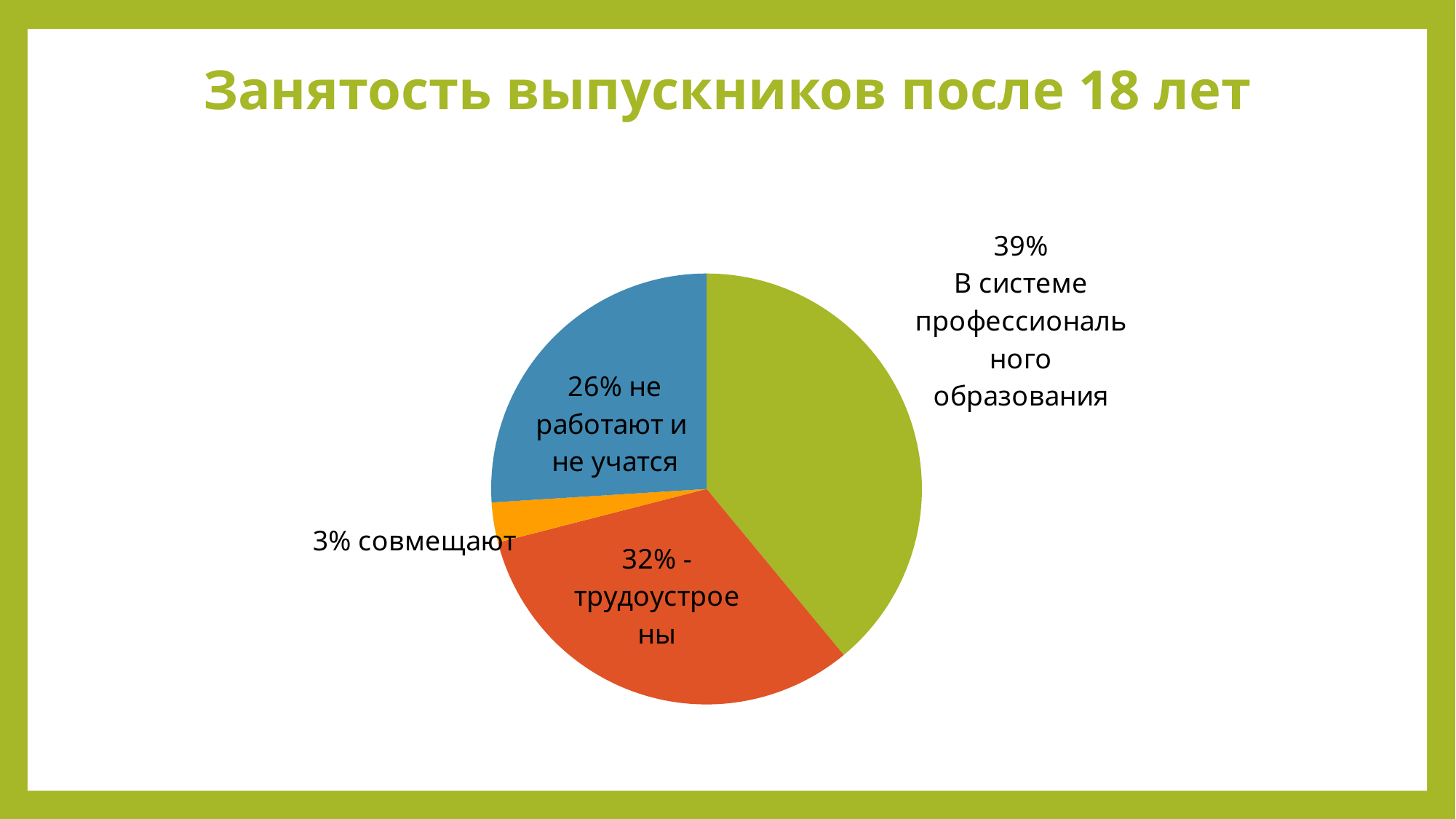
What kind of chart is shown on the slide? pie chart What share of graduates are employed (трудоустроены)? 32% How many slices does the pie chart have? 4 What share of graduates combine work and study (совмещают)? 3% What colour is the slice for graduates who neither work nor study? blue Which category has the smallest share of the pie? совмещают What is the difference between the share in professional education and the share employed? 7% What is the title of the chart? Занятость выпускников после 18 лет Which category has the largest share of the pie? В системе профессионального образования Which is larger: the share employed (трудоустроены) or the share who neither work nor study? трудоустроены What share of graduates neither work nor study (не работают и не учатся)? 26% What share of graduates are in the system of professional education (В системе профессионального образования)? 39%